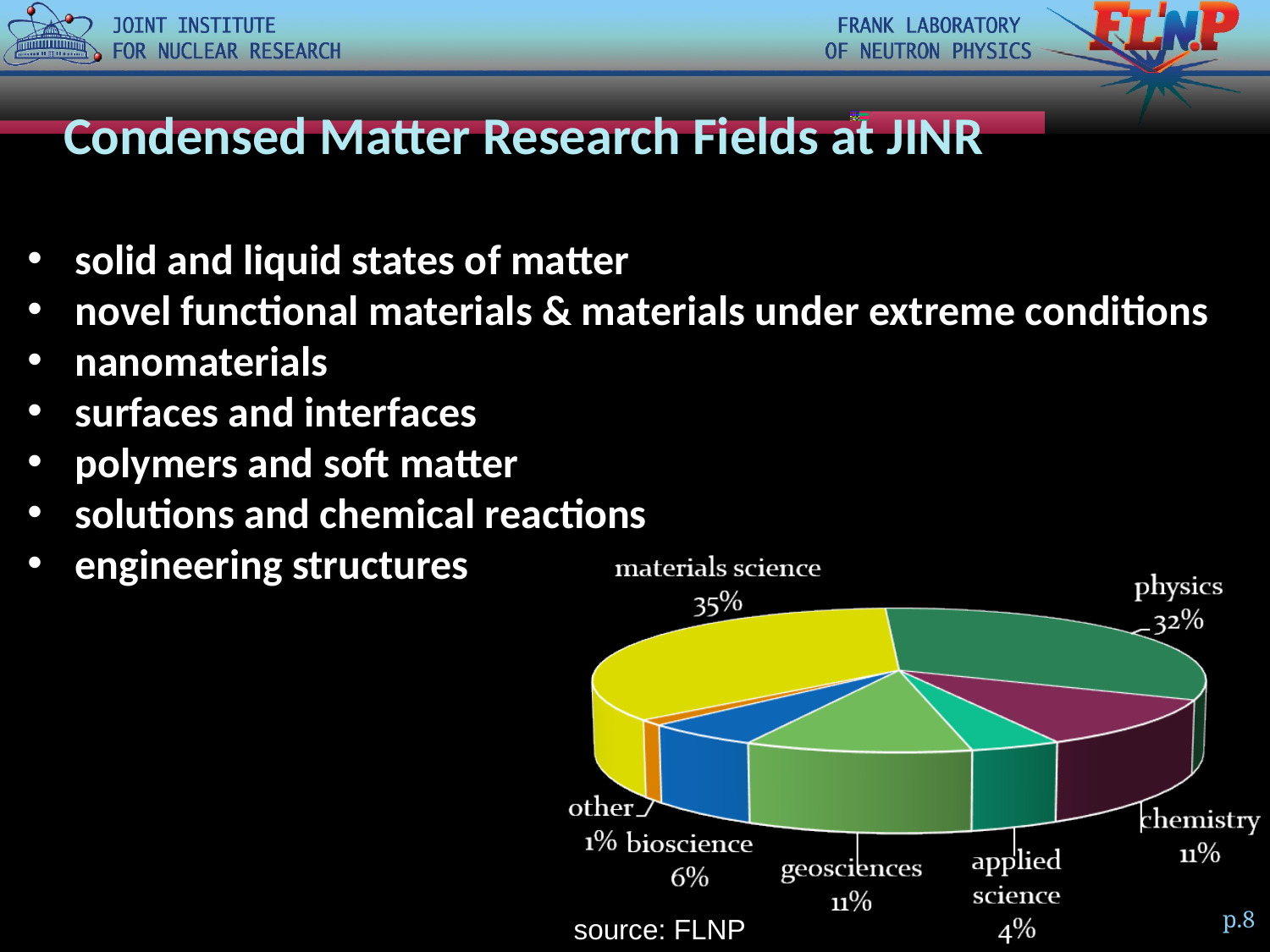
What share of the pie does materials science have? 35% Which is larger, the share for bioscience or the share for applied science? bioscience Which research field has the smallest slice of the pie? other What share of the pie does physics have? 32% How many slices does the pie chart have? 7 What kind of chart is shown on the slide? pie chart What is the difference in percentage points between materials science and physics? 3 What source is cited below the pie chart? FLNP What is the combined share of geosciences and chemistry? 22% What share of the pie does bioscience have? 6% What share of the pie does applied science have? 4% Which research field has the largest slice of the pie? materials science